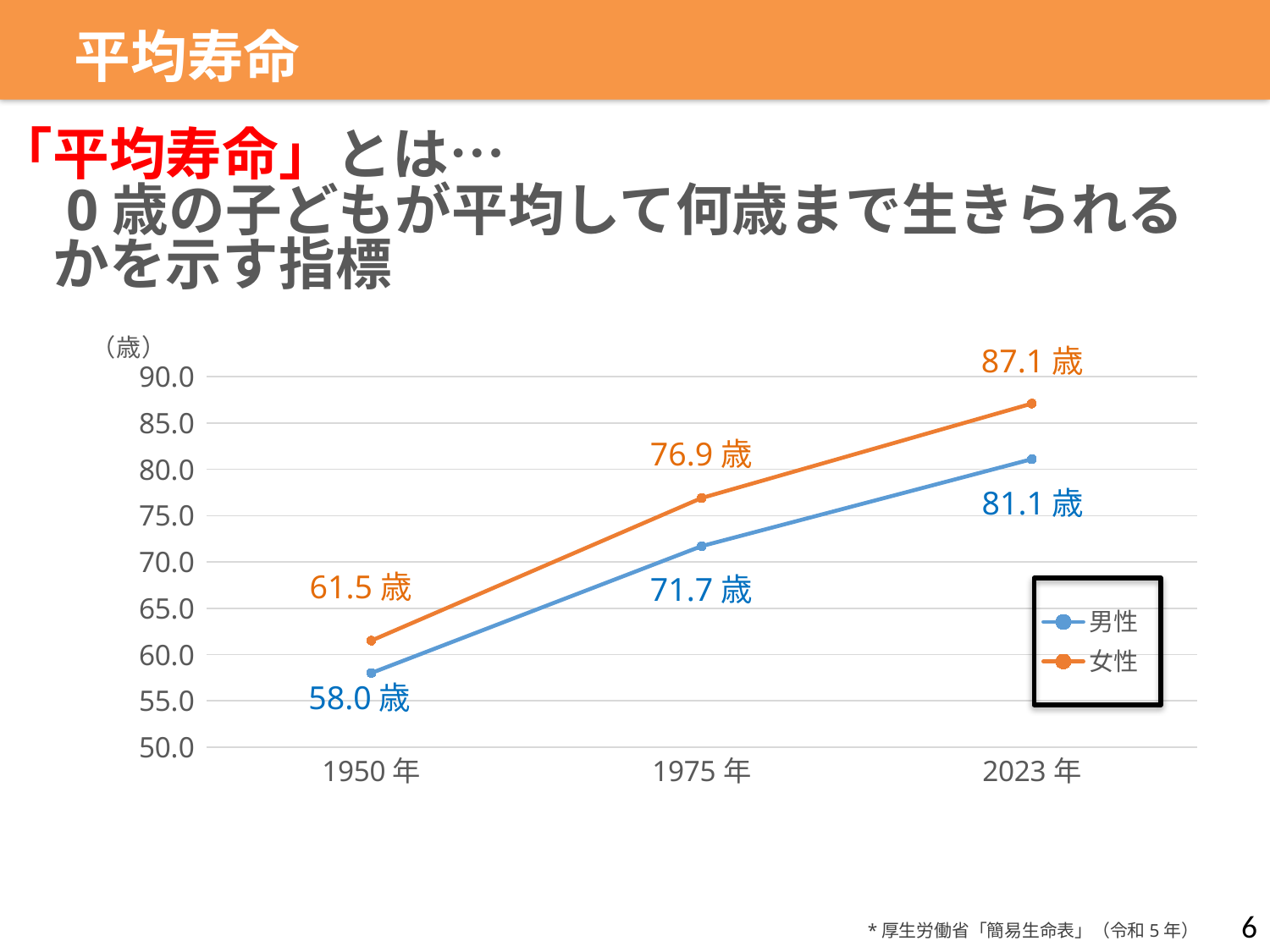
What is the difference between the 女性 and 男性 values in 2023年? 6.0 歳 What is the difference between the 男性 values in 2023年 and 1950年? 23.1 歳 What kind of chart is shown on the slide? line chart In which year is the value for 女性 highest? 2023年 In which year is the value for 男性 lowest? 1950年 How many series does the legend list? 2 What is the value for 男性 in 1950年? 58.0 歳 What is the value for 女性 in 1975年? 76.9 歳 Which is larger in 1975年, the value for 男性 or 女性? 女性 What is the value for 男性 in 2023年? 81.1 歳 What is the value for 女性 in 2023年? 87.1 歳 How many years are shown on the x axis? 3